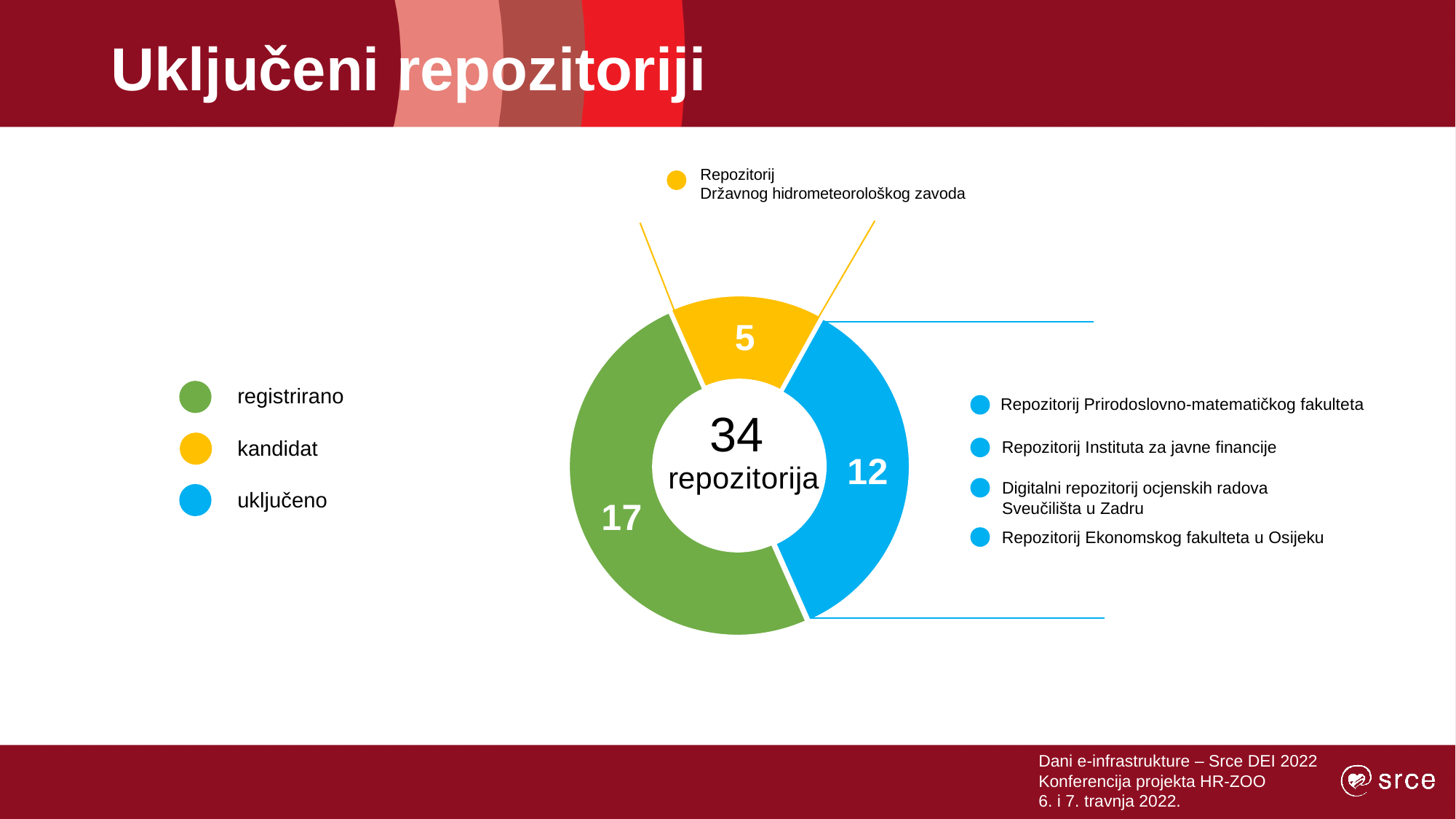
Which category has the lowest value? kandidat What is the value for the 'uključeno' segment? 12 What kind of chart is shown on the slide? Donut (pie) chart What is the value for the 'kandidat' segment? 5 Which category has the highest value? registrirano What colour represents the 'uključeno' category? Blue What is the value for the 'registrirano' segment? 17 What total number is shown in the centre of the donut chart? 34 repozitorija What is the difference between the 'registrirano' and 'uključeno' values? 5 How many categories does the chart show? 3 Which is larger, 'uključeno' or 'kandidat'? uključeno Which repository is annotated next to the yellow 'kandidat' segment? Repozitorij Državnog hidrometeorološkog zavoda